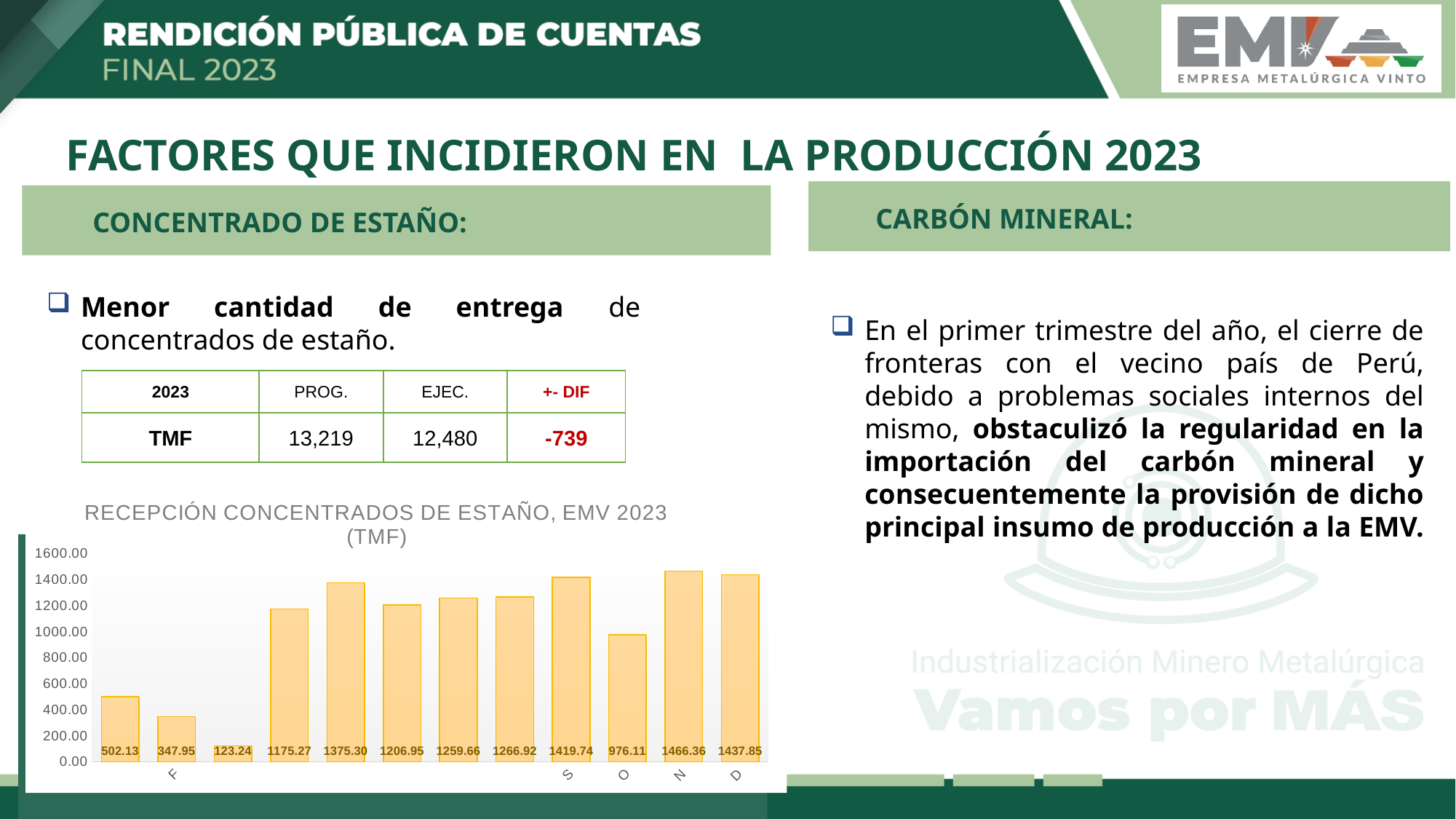
What is the value for O in the chart? 976.11 What type of chart is shown on the slide? bar chart How many bars are plotted in the chart? 12 What is the lowest value shown in the chart? 123.24 What is the value for S in the chart? 1419.74 Which labelled month has the highest value in the chart? N Is the value for O greater or less than 1000.00? less What is the difference between the values for S and O? 443.63 What is the value for N in the chart? 1466.36 What is the value for F in the chart? 347.95 What is the title of the chart? RECEPCIÓN CONCENTRADOS DE ESTAÑO, EMV 2023 (TMF) What is the value for D in the chart? 1437.85